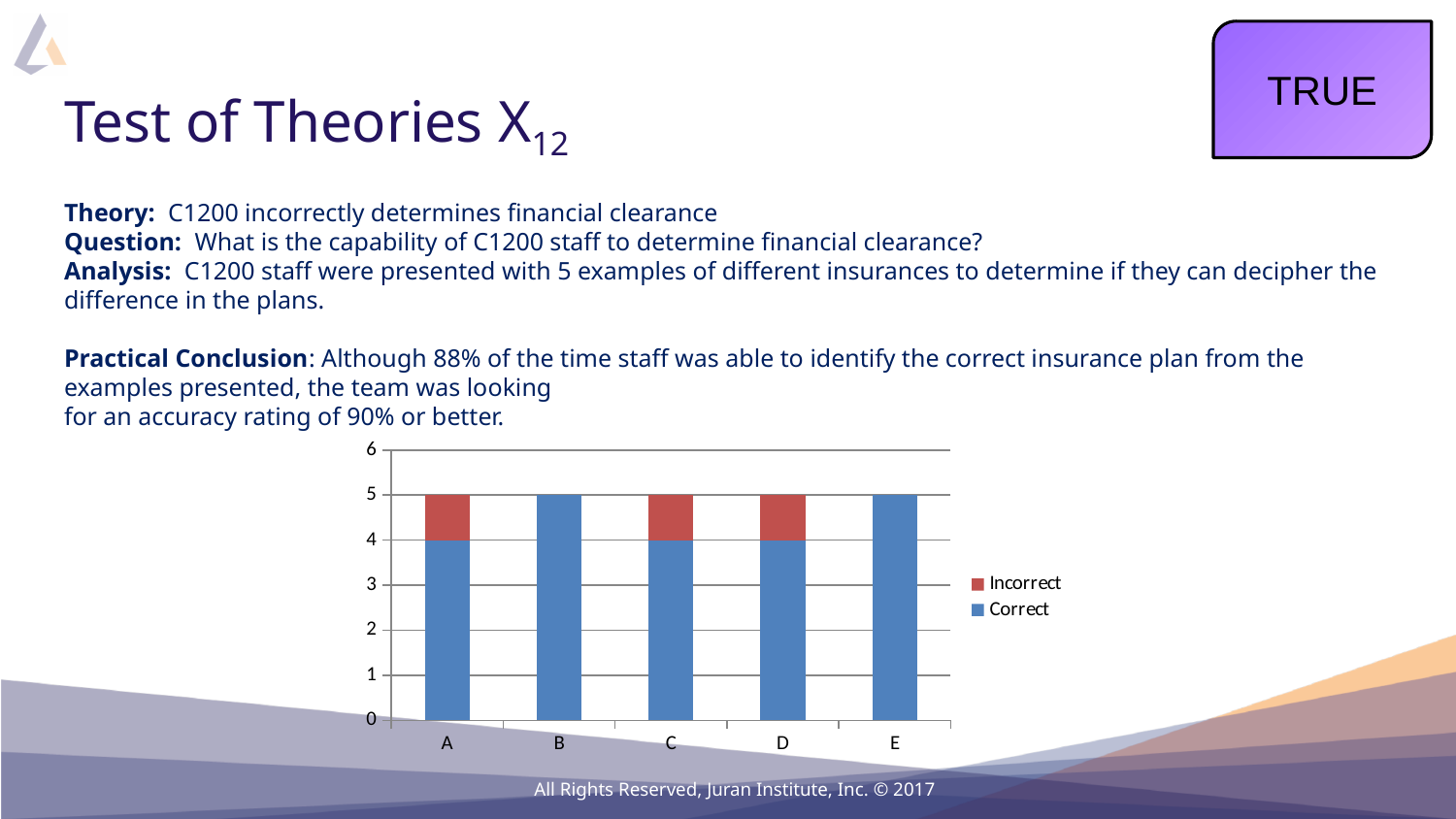
Which is larger, the Correct value for B or the Correct value for A? B What is the Correct value for category B? 5 What is the total height of the stacked bar for category D? 5 What is the Correct value for category A? 4 Is the Correct value for category D greater or less than 3? greater What is the difference between the Correct value for E and the Correct value for C? 1 What kind of chart is shown on the slide? stacked bar chart How many categories are shown on the x axis of the chart? 5 What is the Incorrect value for category C? 1 How many series does the chart legend list? 2 What are the two entries listed in the chart legend? Incorrect and Correct Which series is shown in red in the chart? Incorrect